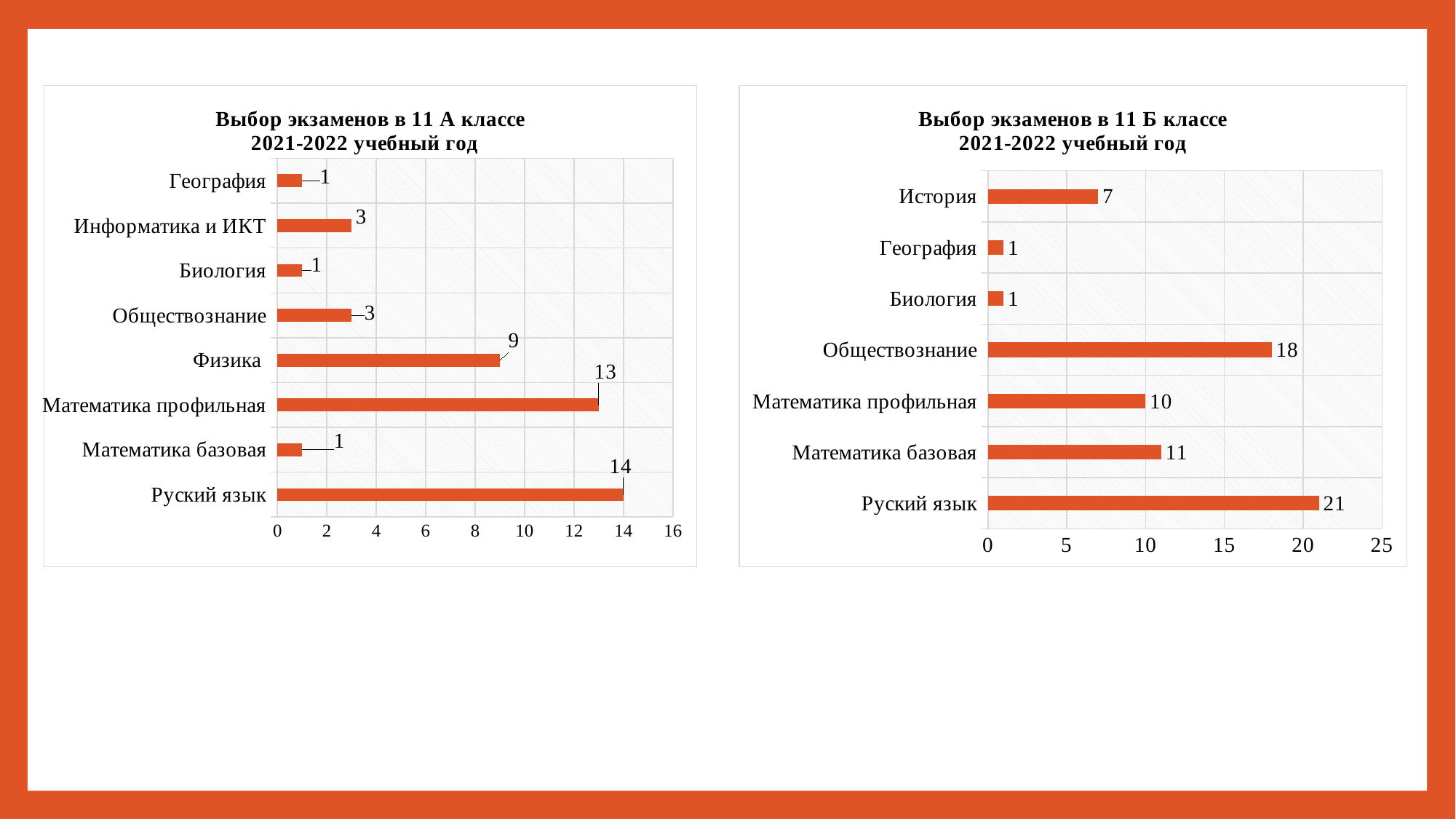
In the chart 'Выбор экзаменов в 11 Б классе', what is the value for Обществознание? 18 In the chart 'Выбор экзаменов в 11 А классе', which category has the highest value? Руский язык In the chart 'Выбор экзаменов в 11 Б классе', which is larger, Математика базовая or Математика профильная? Математика базовая In the chart 'Выбор экзаменов в 11 А классе', what is the value for Математика профильная? 13 In the chart 'Выбор экзаменов в 11 Б классе', how many categories are shown? 7 In the chart 'Выбор экзаменов в 11 Б классе', what is the value for История? 7 In the chart 'Выбор экзаменов в 11 Б классе', what is the difference between Руский язык and Обществознание? 3 In the chart 'Выбор экзаменов в 11 А классе', what is the value for Физика? 9 In the chart 'Выбор экзаменов в 11 А классе', what is the difference between Руский язык and Математика профильная? 1 What type of chart is the chart on the right side of the slide? Bar chart In the chart 'Выбор экзаменов в 11 А классе', how many categories are shown? 8 In the chart 'Выбор экзаменов в 11 Б классе', which category has the highest value? Руский язык